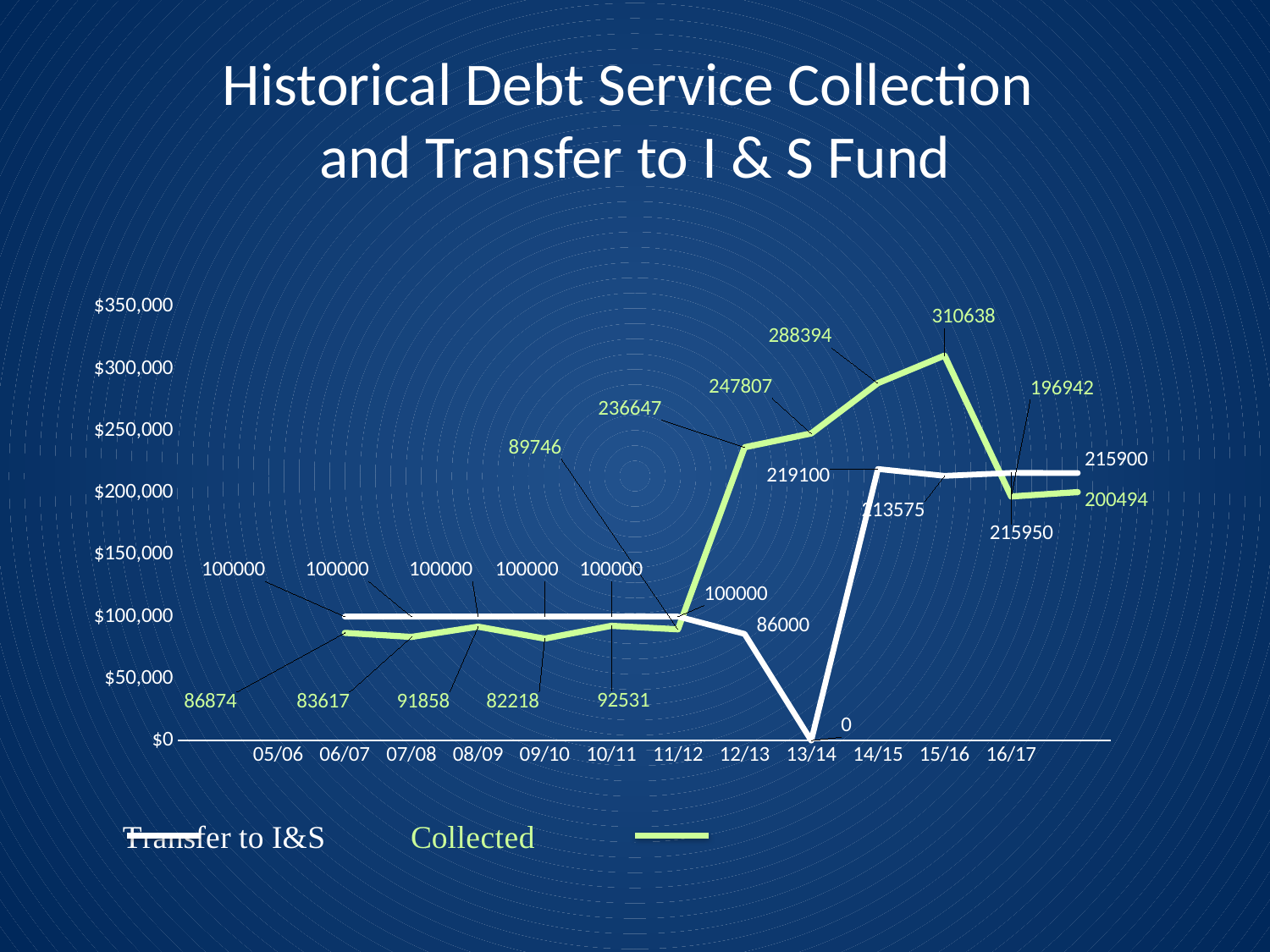
Is the peak value of the Collected line greater or less than $300,000? greater What is the highest value labelled on the Transfer to I&S line? 219100 What is the highest value labelled on the Collected line? 310638 What is the lowest value labelled on the Collected line? 82218 What is the lowest value labelled on the Transfer to I&S line? 0 What is the value of the last data point on the Transfer to I&S line? 215900 Which series reaches a higher peak value, Collected or Transfer to I&S? Collected How many series does the legend list? 2 What is the difference between the peak Collected value (310638) and the Collected value at the next point (196942)? 113696 What is the value of the last data point on the Collected line? 200494 What type of chart is shown on the slide? line chart How many fiscal-year categories are shown on the x axis? 12